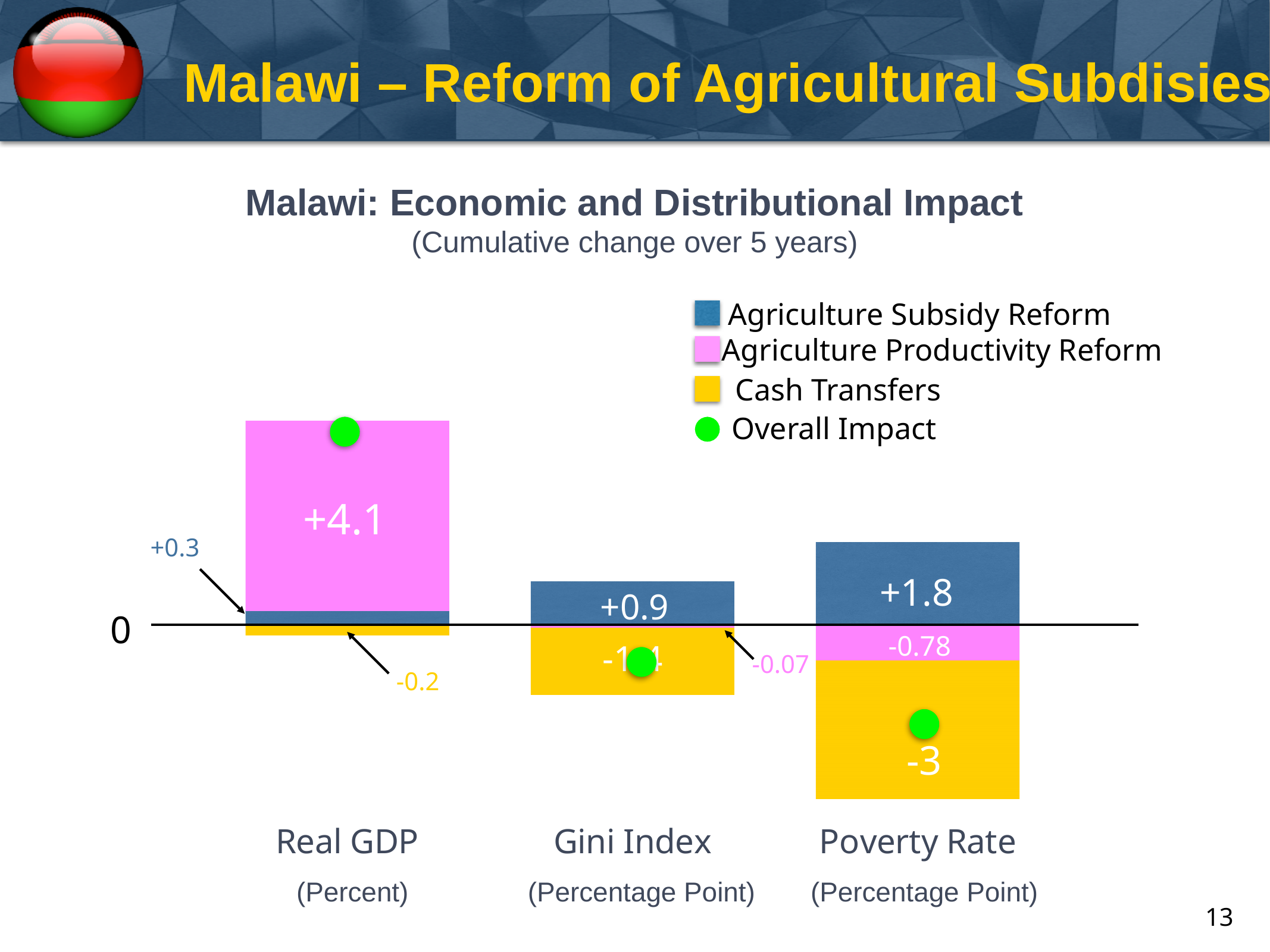
What is the Agriculture Subsidy Reform value for Gini Index? +0.9 Which series is shown as a green dot in the chart legend? Overall Impact What is the Agriculture Productivity Reform value for Poverty Rate? -0.78 How many categories are shown along the x axis of the chart? 3 What is the difference between the Agriculture Subsidy Reform values for Poverty Rate and Gini Index? 0.9 What kind of chart is shown on the slide? bar chart What is the Agriculture Productivity Reform value for Real GDP? +4.1 How many series does the chart legend list? 4 What is the Cash Transfers value for Poverty Rate? -3 Is the Agriculture Subsidy Reform value larger for Poverty Rate or for Gini Index? Poverty Rate What is the Cash Transfers value for Real GDP? -0.2 What is the Agriculture Subsidy Reform value for Poverty Rate? +1.8